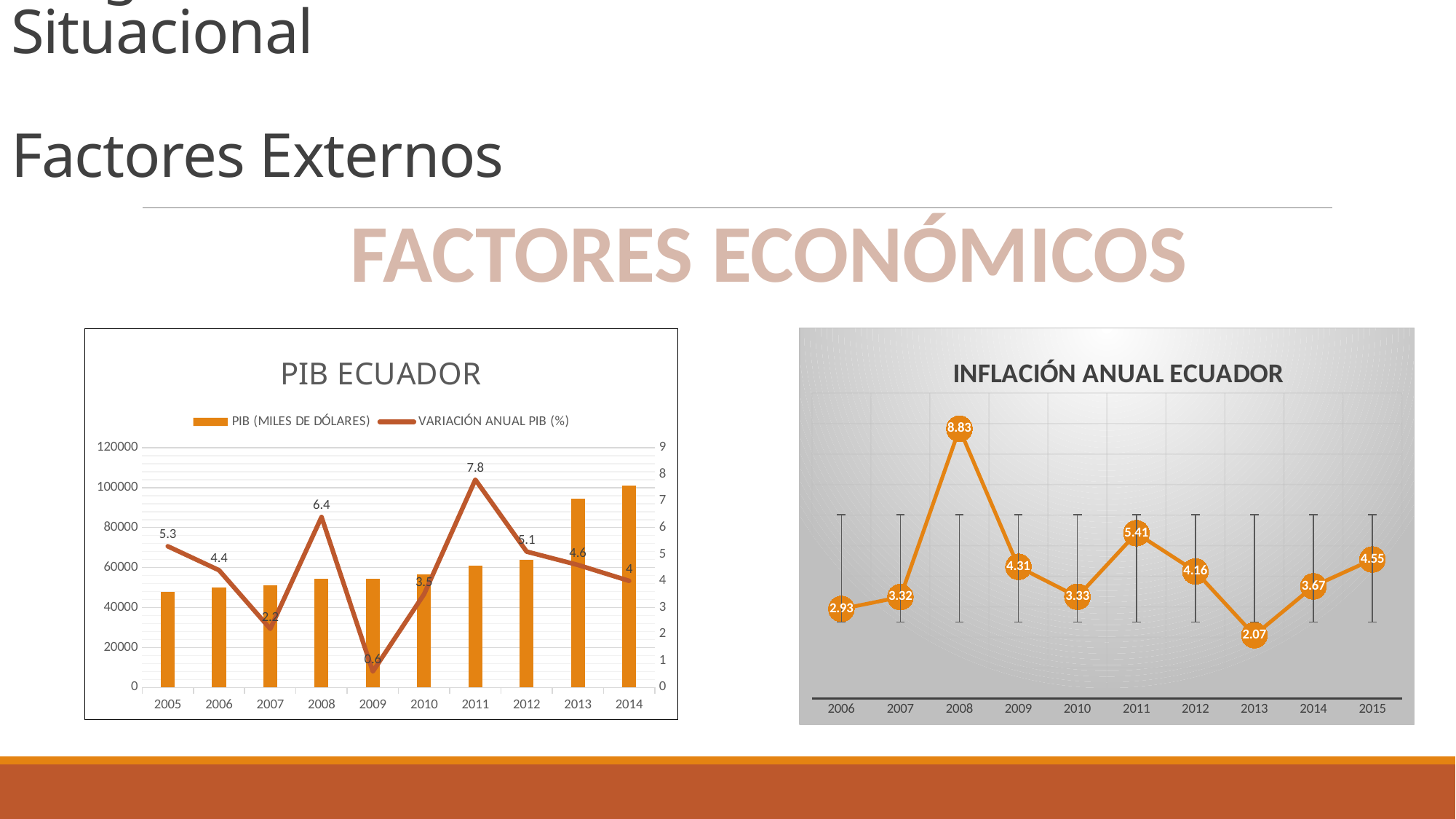
In the INFLACIÓN ANUAL ECUADOR chart, what is the value for 2008? 8.83 In the INFLACIÓN ANUAL ECUADOR chart, what is the difference between the values for 2011 and 2010? 2.08 In the PIB ECUADOR chart, which year has the lowest VARIACIÓN ANUAL PIB (%)? 2009 In the INFLACIÓN ANUAL ECUADOR chart, which is larger, the value for 2012 or the value for 2014? 2012 In the PIB ECUADOR chart, what is the difference between the VARIACIÓN ANUAL PIB (%) values for 2008 and 2007? 4.2 In the PIB ECUADOR chart, how many series does the legend list? 2 In the PIB ECUADOR chart, is the PIB (MILES DE DÓLARES) bar for 2014 greater or less than 80000? greater In the PIB ECUADOR chart, what is the VARIACIÓN ANUAL PIB (%) value for 2011? 7.8 In the PIB ECUADOR chart, is the PIB (MILES DE DÓLARES) bar for 2005 greater or less than 60000? less In the INFLACIÓN ANUAL ECUADOR chart, which year has the lowest value? 2013 In the INFLACIÓN ANUAL ECUADOR chart, how many years are plotted? 10 In the PIB ECUADOR chart, what is the VARIACIÓN ANUAL PIB (%) value for 2009? 0.6